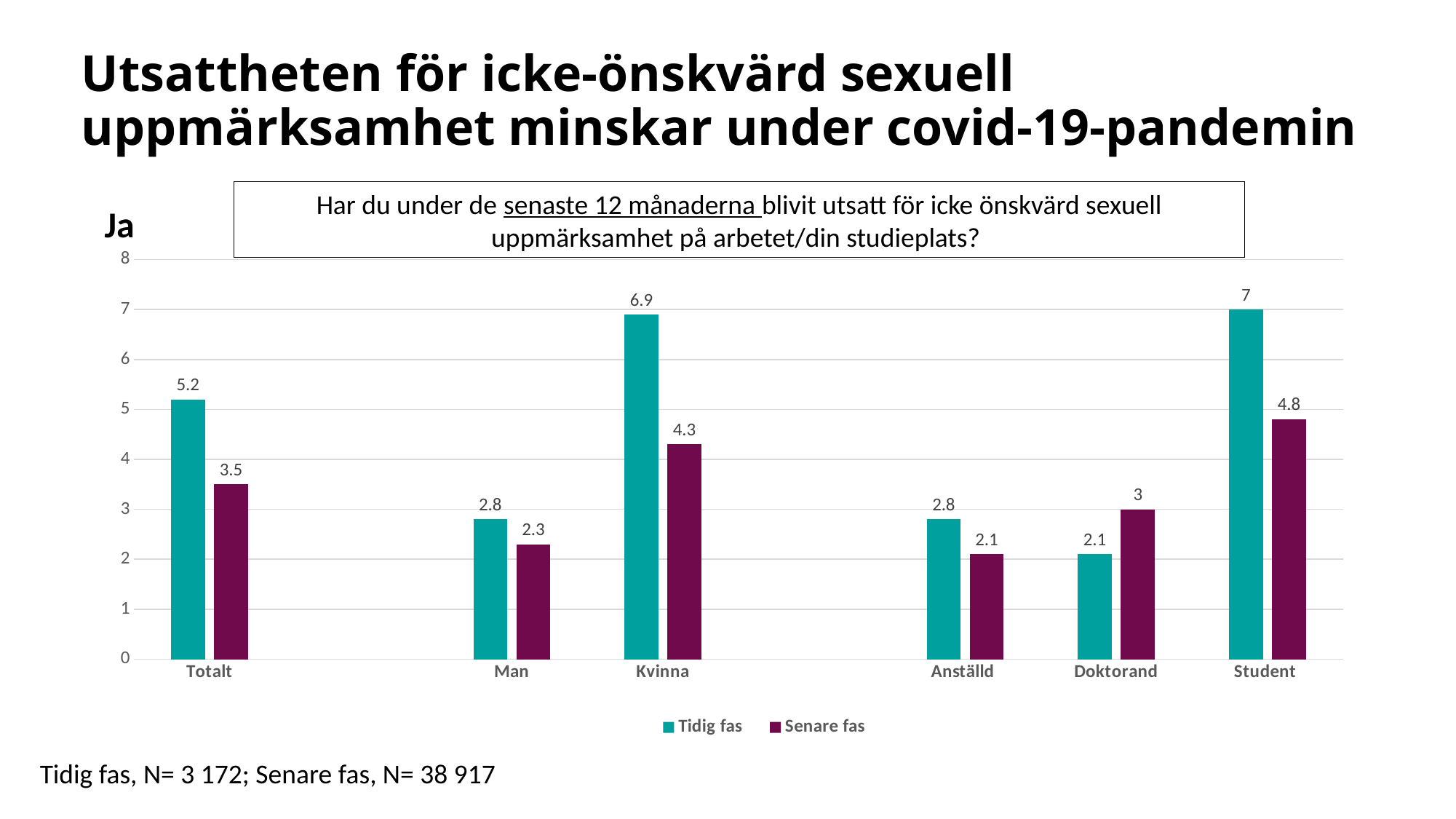
What kind of chart is shown on the slide? Bar chart How many categories are shown on the x axis? 6 Is the Tidig fas value for Student greater or less than 6? greater Which category has the lowest value in the Senare fas series? Anställd What is the difference between the Tidig fas and Senare fas values for Kvinna? 2.6 What is the value for Doktorand in the Senare fas series? 3 What is the value for Kvinna in the Tidig fas series? 6.9 For Doktorand, which series has the larger value, Tidig fas or Senare fas? Senare fas How many series does the legend list? 2 What is the difference between the Tidig fas and Senare fas values for Totalt? 1.7 What is the value for Student in the Senare fas series? 4.8 Which category has the highest value in the Tidig fas series? Student